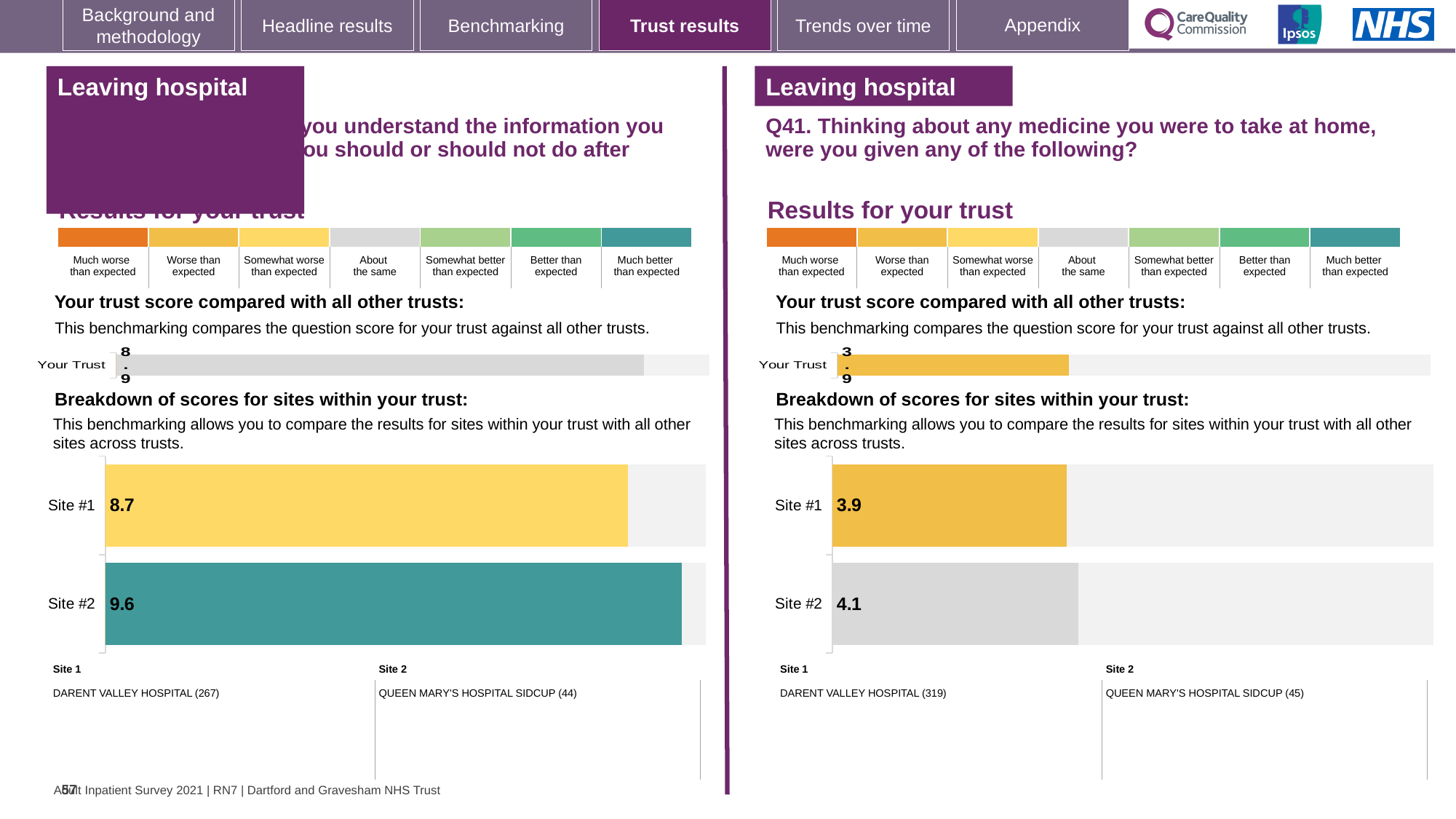
On the right-hand chart (Q41), what is the score for Site #2? 4.1 On the left-hand chart, what is the difference between the Site #2 and Site #1 scores? 0.9 On the right-hand chart (Q41), what is the score shown for Your Trust? 3.9 On the left-hand chart, what is the score for Site #1? 8.7 On the left-hand chart, what is the score for Site #2? 9.6 On the left-hand chart, what is the score shown for Your Trust? 8.9 On the right-hand chart (Q41), what is the difference between the Site #2 and Site #1 scores? 0.2 On the left-hand chart, which site has the higher score, Site #1 or Site #2? Site #2 On the right-hand chart (Q41), which site has the lower score? Site #1 On the right-hand chart (Q41), what is the score for Site #1? 3.9 What type of chart is used for the breakdown of scores for sites on the left-hand side? Bar chart How many sites are shown in the site breakdown chart on the right-hand side (Q41)? 2